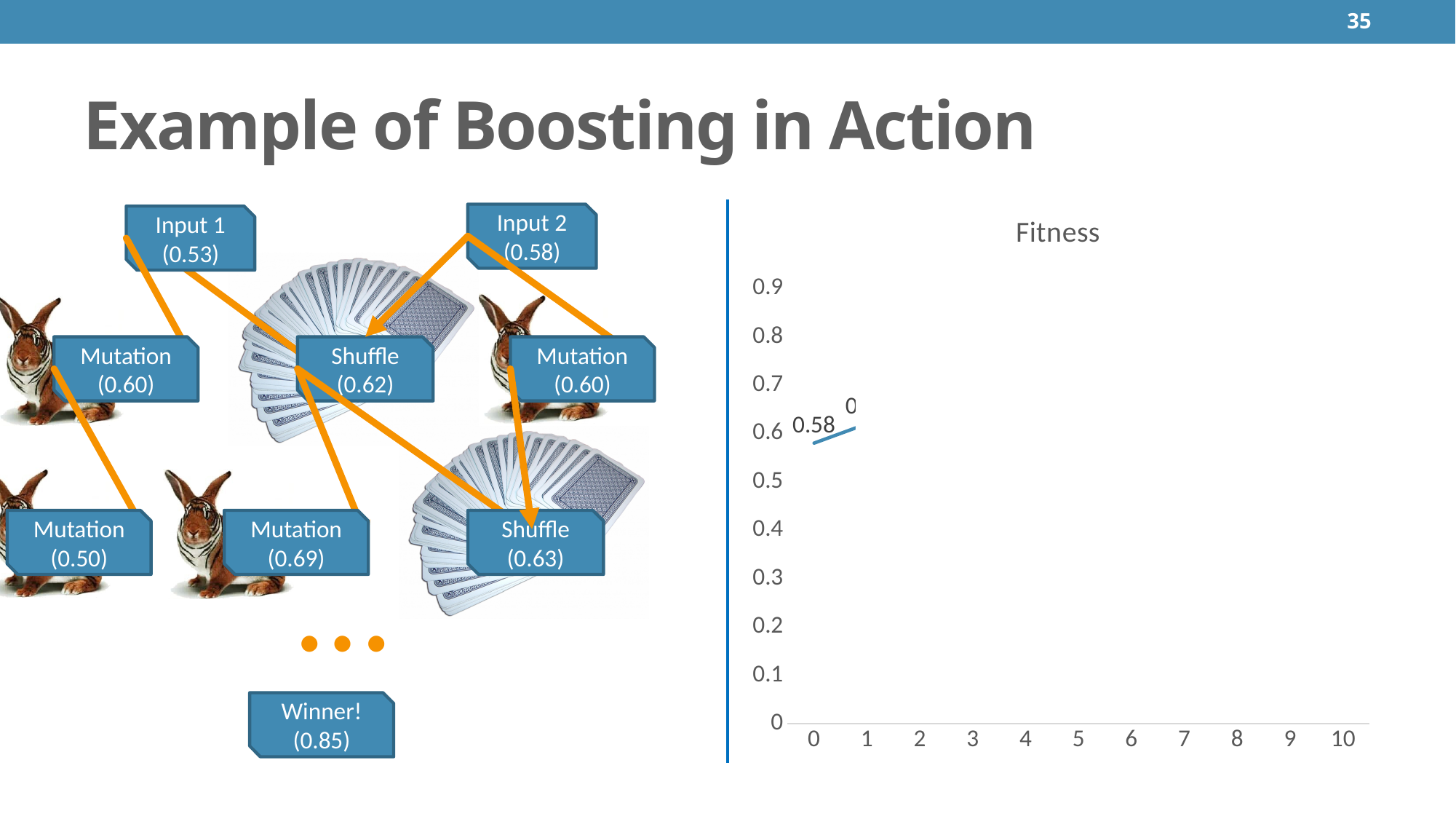
How many tick labels are shown on the x axis of the Fitness chart? 11 What is the title of the chart on the right side of the slide? Fitness In the Fitness chart, is the value at x = 1 greater or less than 0.7? less What kind of chart is the Fitness chart? line chart In the Fitness chart, what is the value plotted at x = 0? 0.58 In the Fitness chart, which is larger: the value at x = 0 or the value at x = 1? x = 1 In the Fitness chart, is the value at x = 1 greater or less than 0.5? greater In the Fitness chart, does the line rise or fall from x = 0 to x = 1? rise What is the highest value labelled on the y axis of the Fitness chart? 0.9